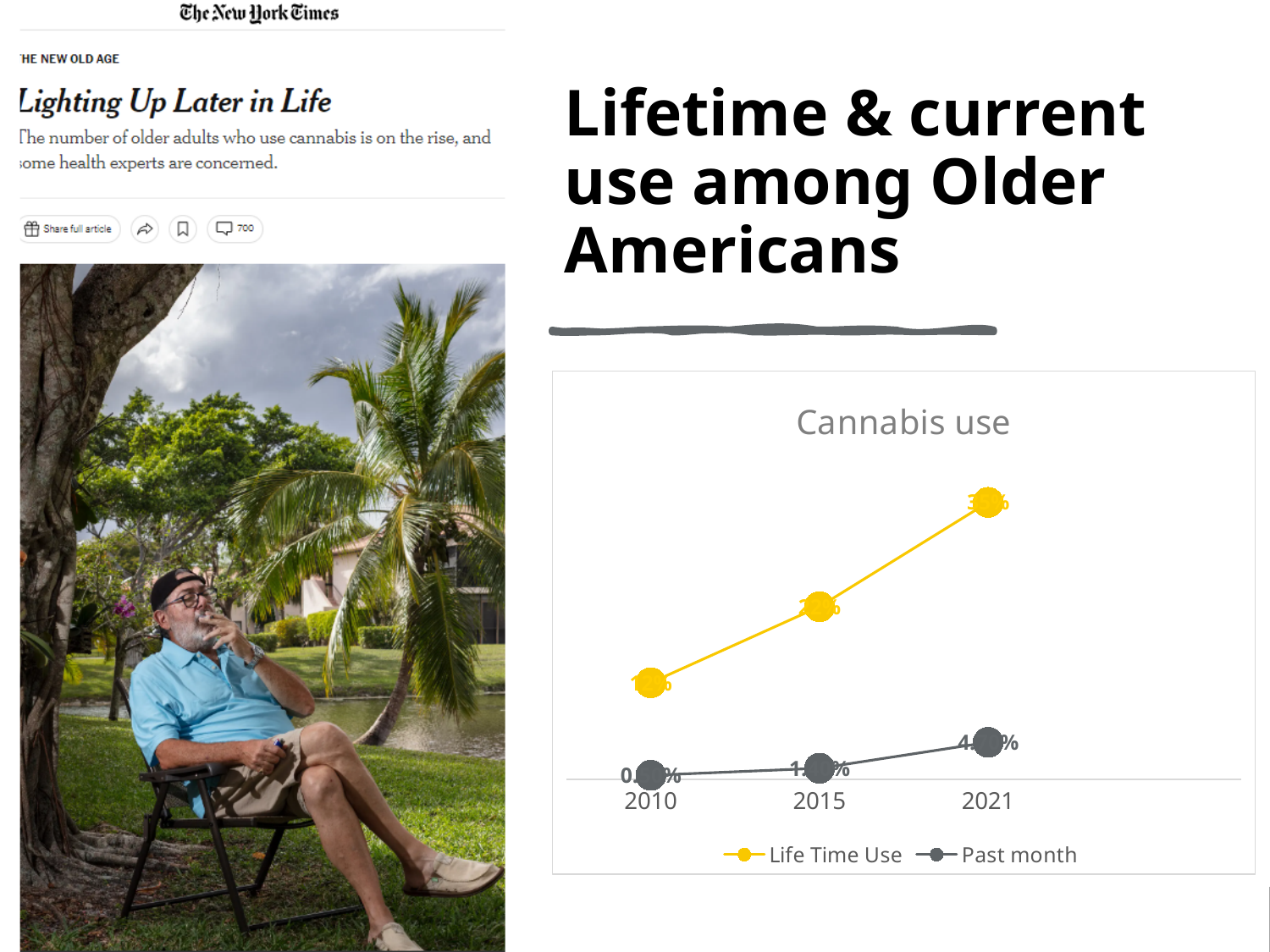
Which two series are listed in the chart's legend? Life Time Use and Past month In 2021, which series has the larger value, Life Time Use or Past month? Life Time Use What kind of chart is shown on the slide? line chart In which year is Life Time Use highest? 2021 Which years are shown on the x axis of the chart? 2010, 2015, 2021 How many years are shown on the x axis of the chart? 3 How many series does the chart's legend list? 2 In which year is Life Time Use lowest? 2010 Does the Past month series rise or fall from 2010 to 2021? rise In which year is Past month use lowest? 2010 What is the title of the chart? Cannabis use Does the Life Time Use series rise or fall from 2010 to 2021? rise